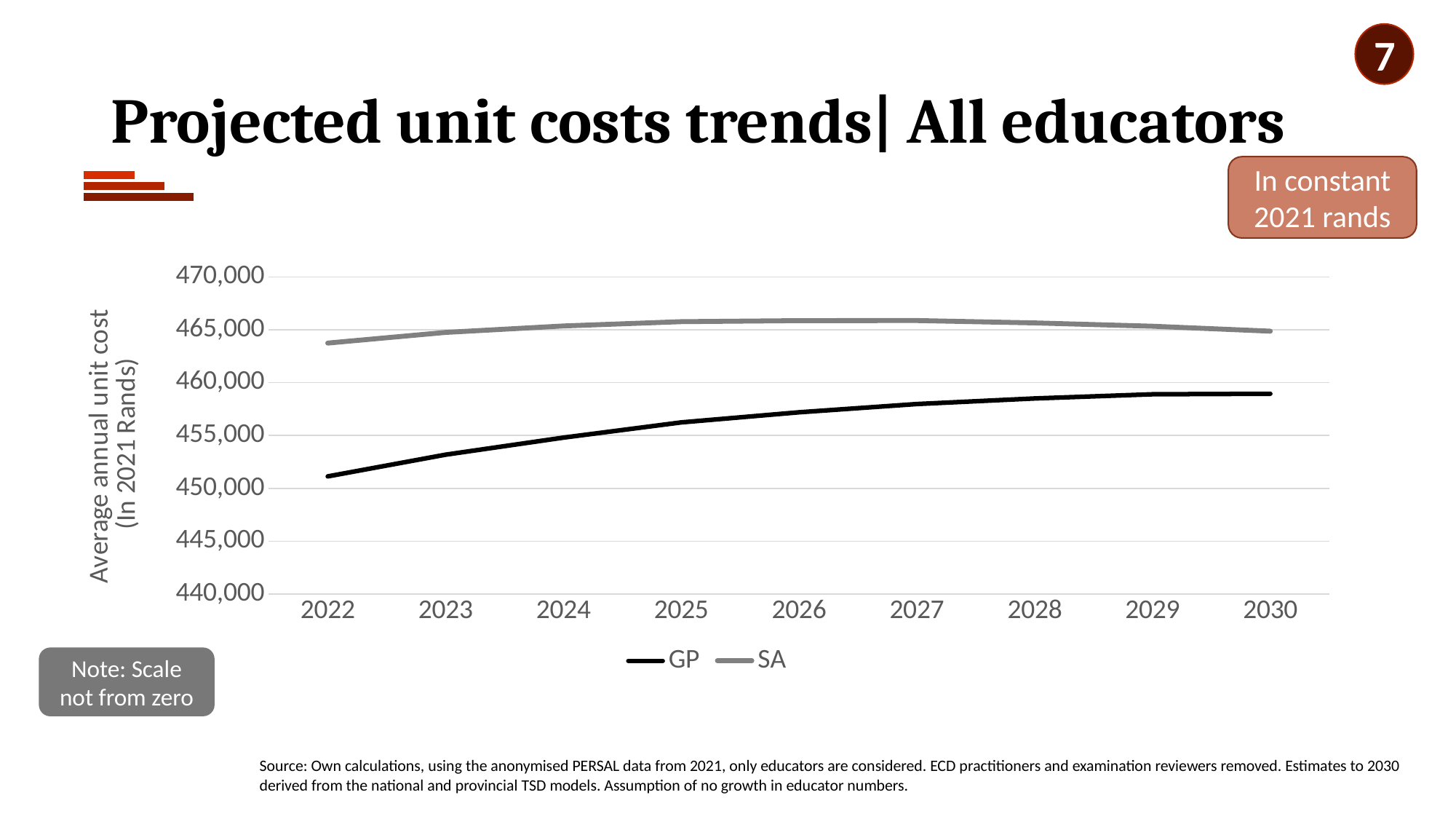
Is the value for GP in 2030 greater or less than 460,000? less How many series does the legend list? 2 Does the GP line rise or fall from 2022 to 2030? rise Is the value for GP in 2030 greater or less than 455,000? greater Is the value for SA in 2022 greater or less than 460,000? greater In which year is the GP series at its lowest? 2022 What kind of chart is shown on the slide? line chart What is the y-axis title of the chart? Average annual unit cost (In 2021 Rands) How many years are plotted along the x axis? 9 Which series is drawn in black? GP In 2022, which series has the higher value, GP or SA? SA